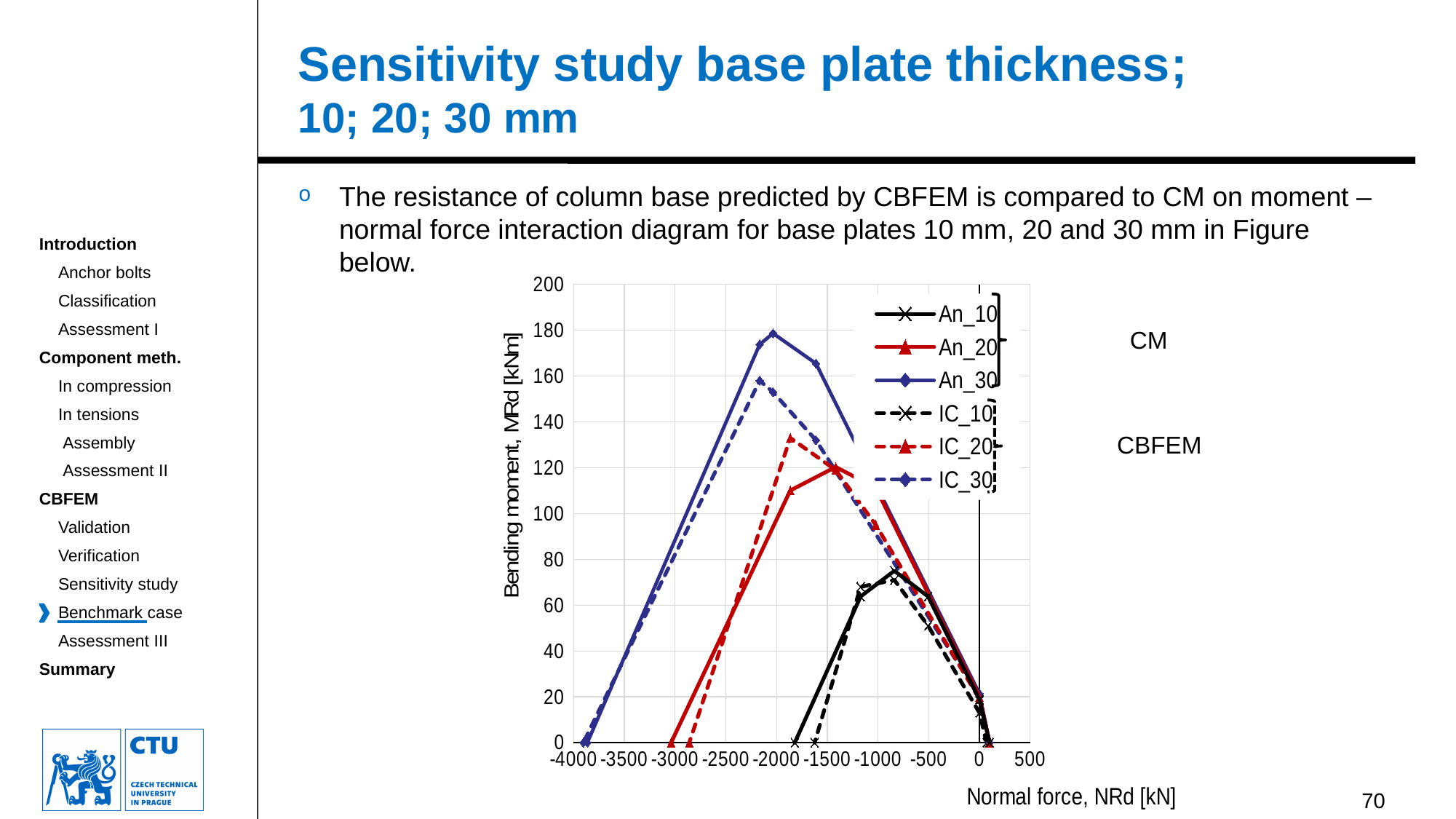
Which series reaches a higher peak bending moment, An_20 or An_30? An_30 What is the title of the vertical axis of the chart? Bending moment, MRd [kNm] Which group label is attached to the An_10, An_20 and An_30 legend entries? CM How many series does the chart legend list? 6 Is the peak bending moment of the An_30 series greater or less than 160? greater Is the peak bending moment of the IC_30 series greater or less than 180? less Is the peak bending moment of the An_10 series greater or less than 100? less Which series reaches a higher peak bending moment, An_10 or An_20? An_20 Which series reaches the highest bending moment on the chart? An_30 What kind of chart is shown on the slide? line chart